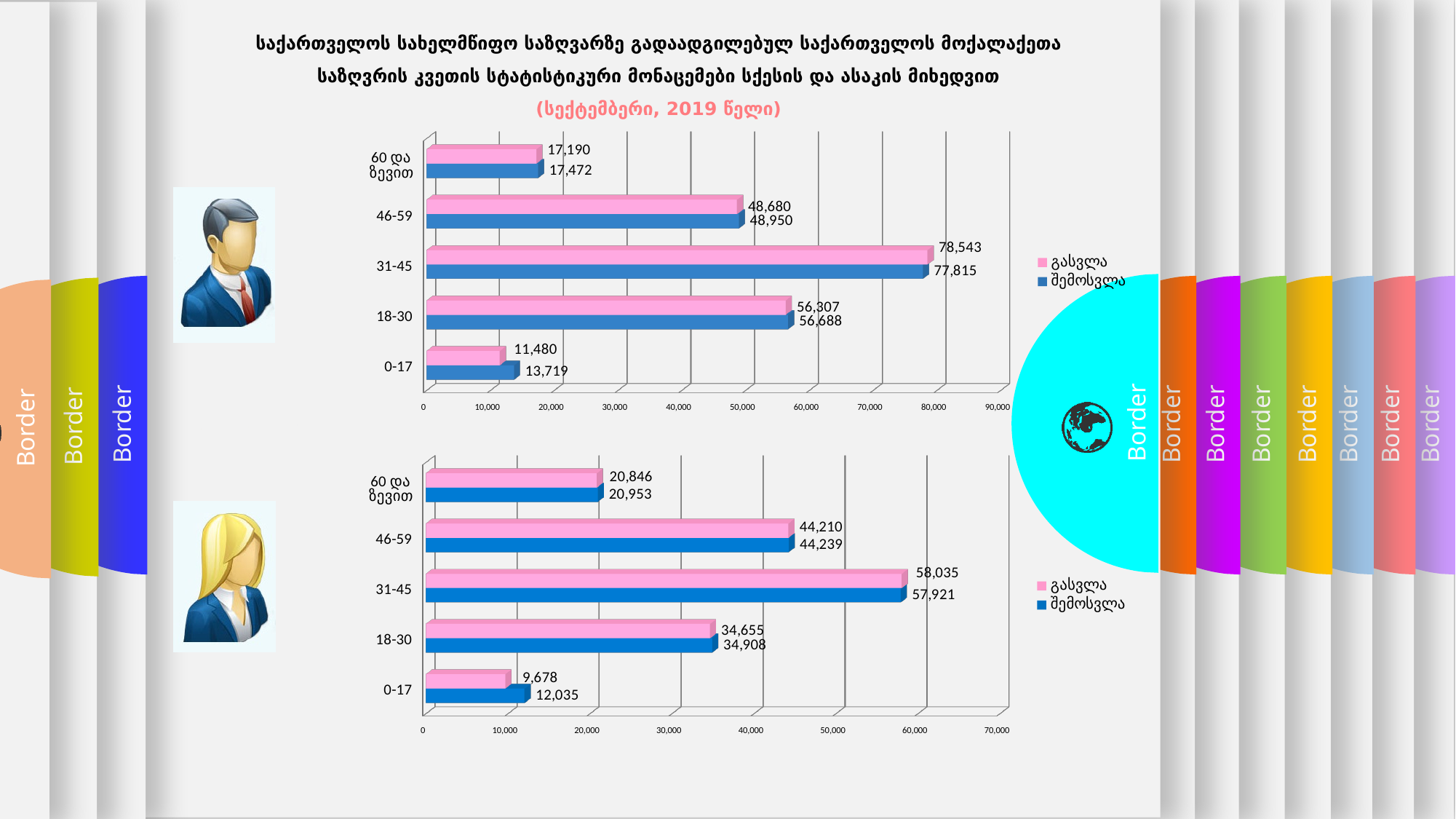
In the bottom chart, what is the გასვლა value for the 60 და ზევით age group? 20,846 In the top chart, which age group has the highest გასვლა value? 31-45 In the top chart, what is the გასვლა value for the 31-45 age group? 78,543 In the top chart, what is the შემოსვლა value for the 0-17 age group? 13,719 In the bottom chart, which age group has the lowest შემოსვლა value? 0-17 How many age groups are shown in the top chart? 5 In the bottom chart, what is the შემოსვლა value for the 18-30 age group? 34,908 How many series does the legend of the bottom chart list? 2 What type of chart is the top chart? Bar chart In the top chart, what is the difference between the შემოსვლა and გასვლა values for the 0-17 age group? 2,239 In the bottom chart, what is the difference between the გასვლა values for 31-45 and 18-30? 23,380 In the bottom chart, which is larger for the 46-59 age group: გასვლა or შემოსვლა? შემოსვლა